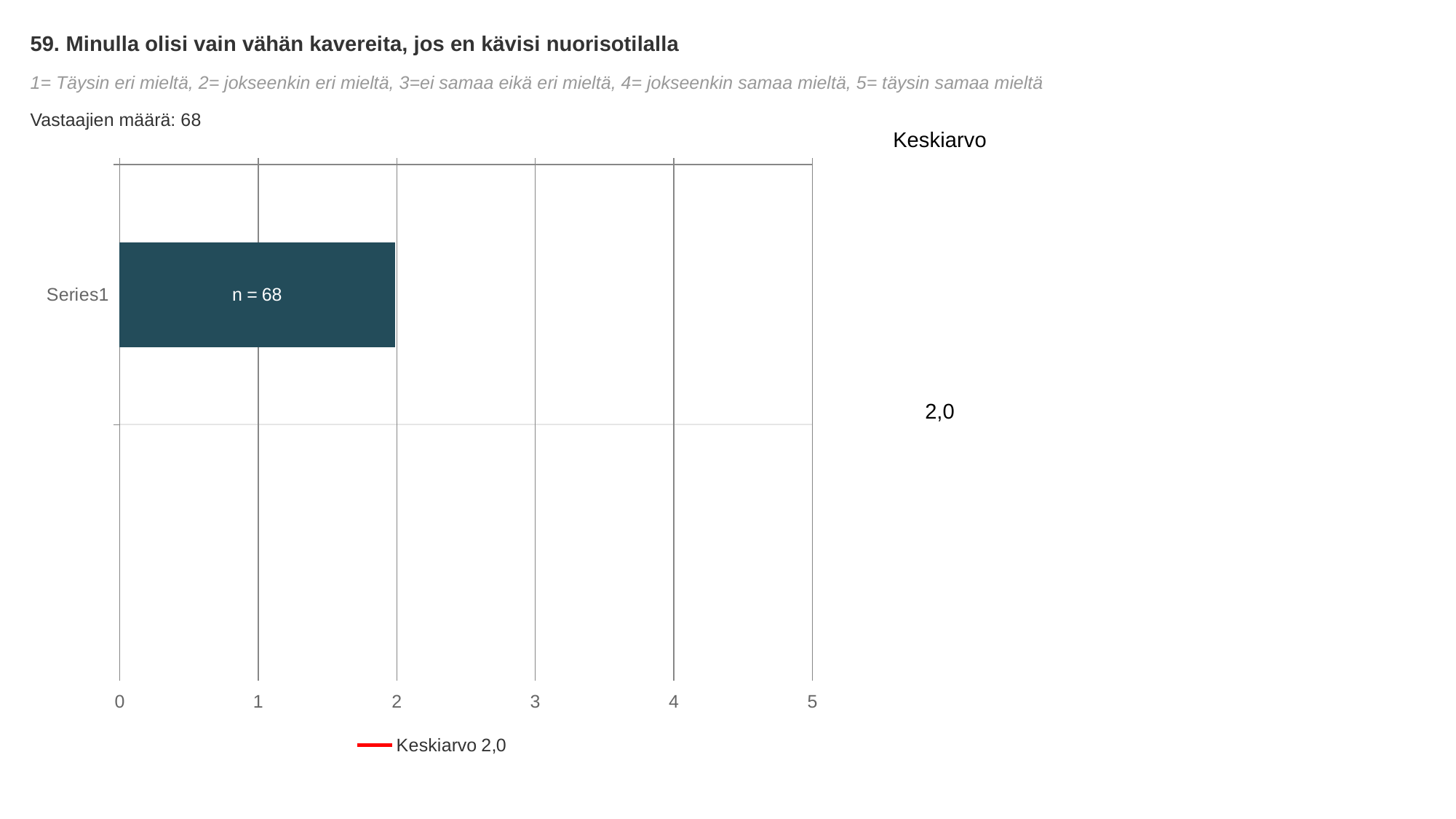
What does the legend entry below the chart say? Keskiarvo 2,0 What is the maximum value shown on the x axis? 5 What is the value of the bar for Series1? 2,0 How many bars are plotted in the chart? 1 What data label is printed inside the bar for Series1? n = 68 What kind of chart is shown on the slide? bar chart Is the value for Series1 greater or less than 1? greater Is the value for Series1 greater or less than 3? less How many respondents (Vastaajien määrä) are reported on the slide? 68 What is the Keskiarvo (mean) value shown on the slide? 2,0